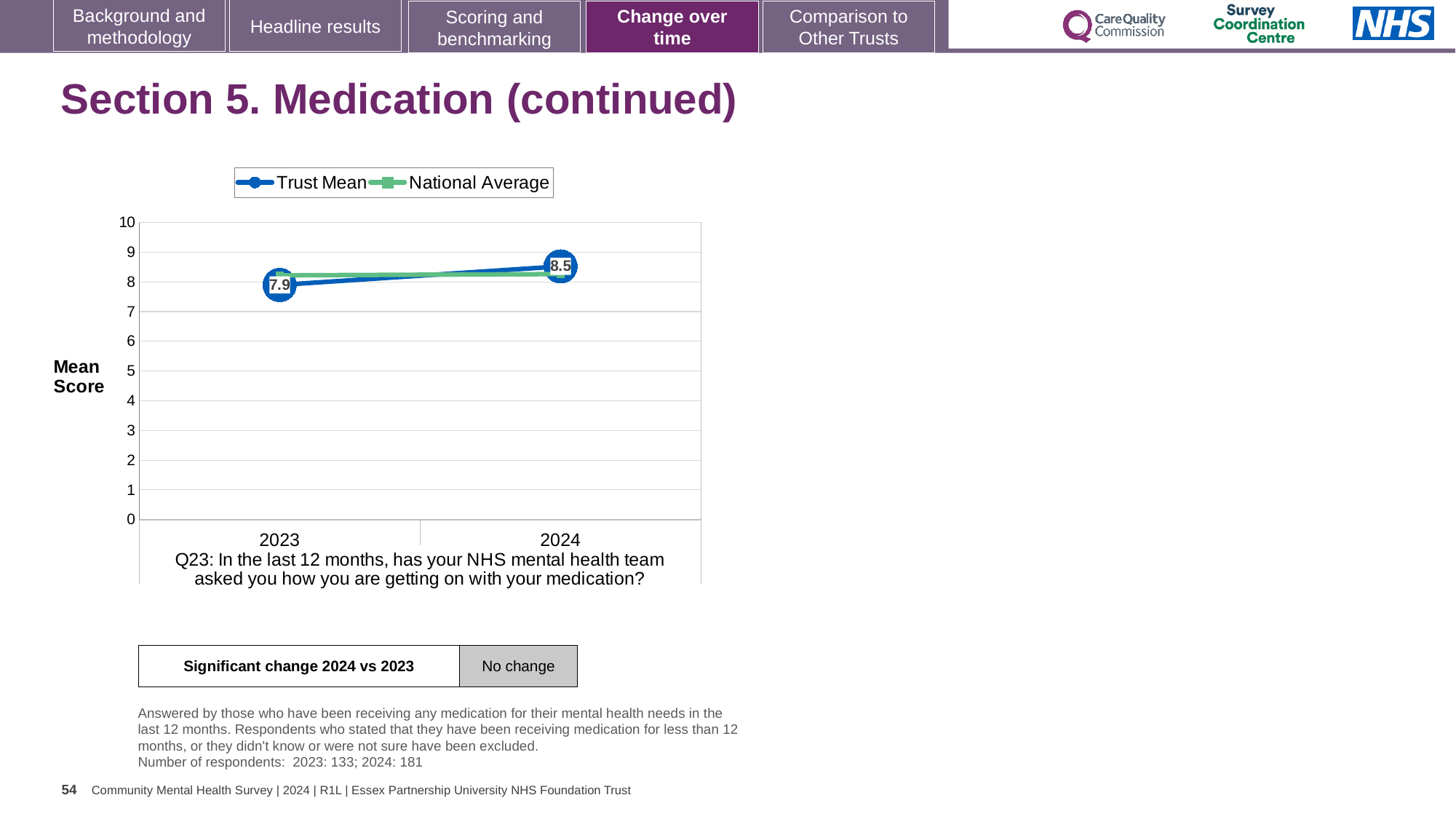
What is the Trust Mean score for 2023? 7.9 Which year has the higher Trust Mean score, 2023 or 2024? 2024 Does the Trust Mean rise or fall from 2023 to 2024? rise What kind of chart is shown on the slide? line chart What is the Trust Mean score for 2024? 8.5 Is the Trust Mean value for 2023 greater or less than 7? greater Is the National Average value for 2023 greater or less than 5? greater By how much did the Trust Mean score change from 2023 to 2024? 0.6 How many series does the legend list? 2 How many years are plotted on the x axis? 2 What is the label on the y axis of the chart? Mean Score In 2023, which is higher, the Trust Mean or the National Average? National Average